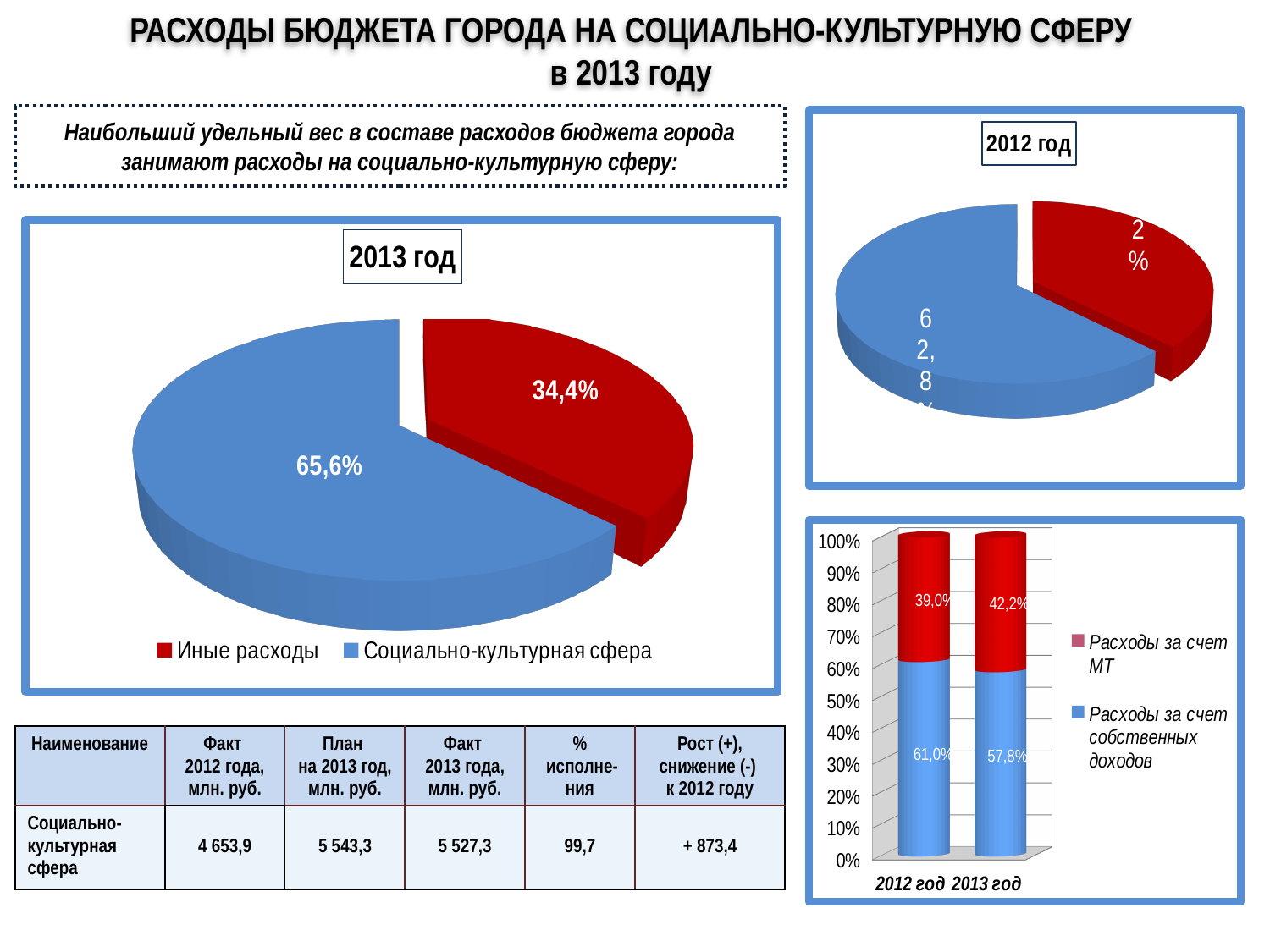
What kind of chart is the '2013 год' chart? Pie chart How many series does the legend of the stacked bar chart at the bottom right list? 2 In the '2013 год' pie chart, which slice is larger: Иные расходы or Социально-культурная сфера? Социально-культурная сфера In the '2013 год' pie chart, what is the difference between the Социально-культурная сфера share and the Иные расходы share? 31,2% In the '2013 год' pie chart, which colour is used for Иные расходы? Red In the stacked bar chart at the bottom right, what is the value for Расходы за счет собственных доходов in 2012 год? 61,0% In the stacked bar chart at the bottom right, what is the value for Расходы за счет МТ in 2012 год? 39,0% How many entries does the legend of the '2013 год' pie chart list? 2 In the stacked bar chart at the bottom right, does the share of Расходы за счет собственных доходов rise or fall from 2012 год to 2013 год? Fall In the '2013 год' pie chart, what share is labelled for Социально-культурная сфера? 65,6% In the stacked bar chart at the bottom right, what is the value for Расходы за счет МТ in 2013 год? 42,2% In the '2013 год' pie chart, what share is labelled for Иные расходы? 34,4%